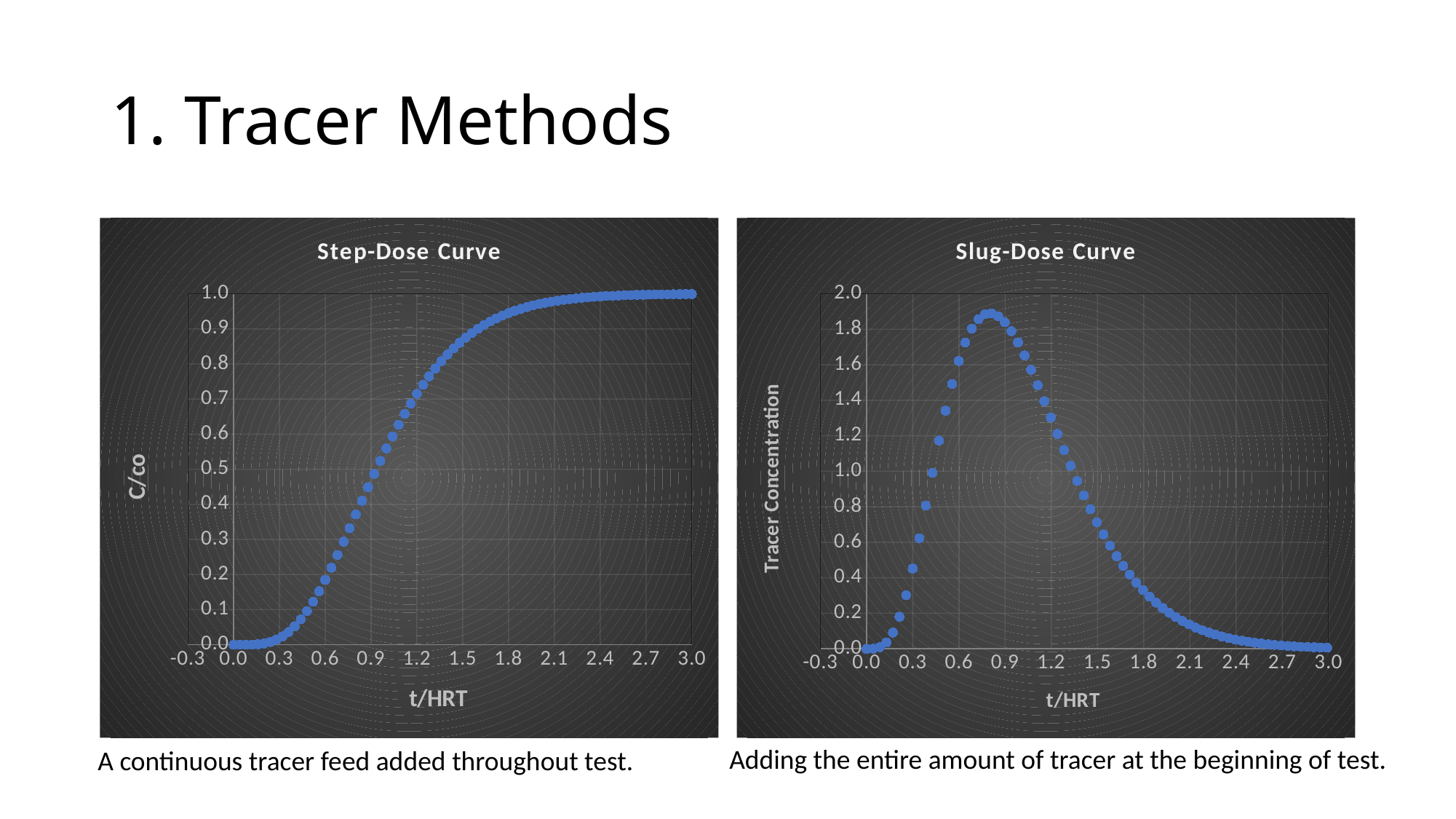
In the Step-Dose Curve, is the value of C/co at t/HRT = 0.3 greater or less than 0.1? less In the Slug-Dose Curve, is the tracer concentration at t/HRT = 2.4 greater or less than 0.2? less In the Step-Dose Curve, is the value of C/co at t/HRT = 2.1 greater or less than 0.9? greater In the Slug-Dose Curve, does the peak occur before or after t/HRT = 1.2? Before In the Step-Dose Curve, do the values rise or fall as t/HRT increases? Rise What kind of chart is the Slug-Dose Curve? Scatter chart What kind of chart is the Step-Dose Curve? Scatter chart In the Slug-Dose Curve, how do the values change as t/HRT increases from 0.0 to 3.0? Rise to a peak, then fall What is the y-axis label of the Slug-Dose Curve chart? Tracer Concentration